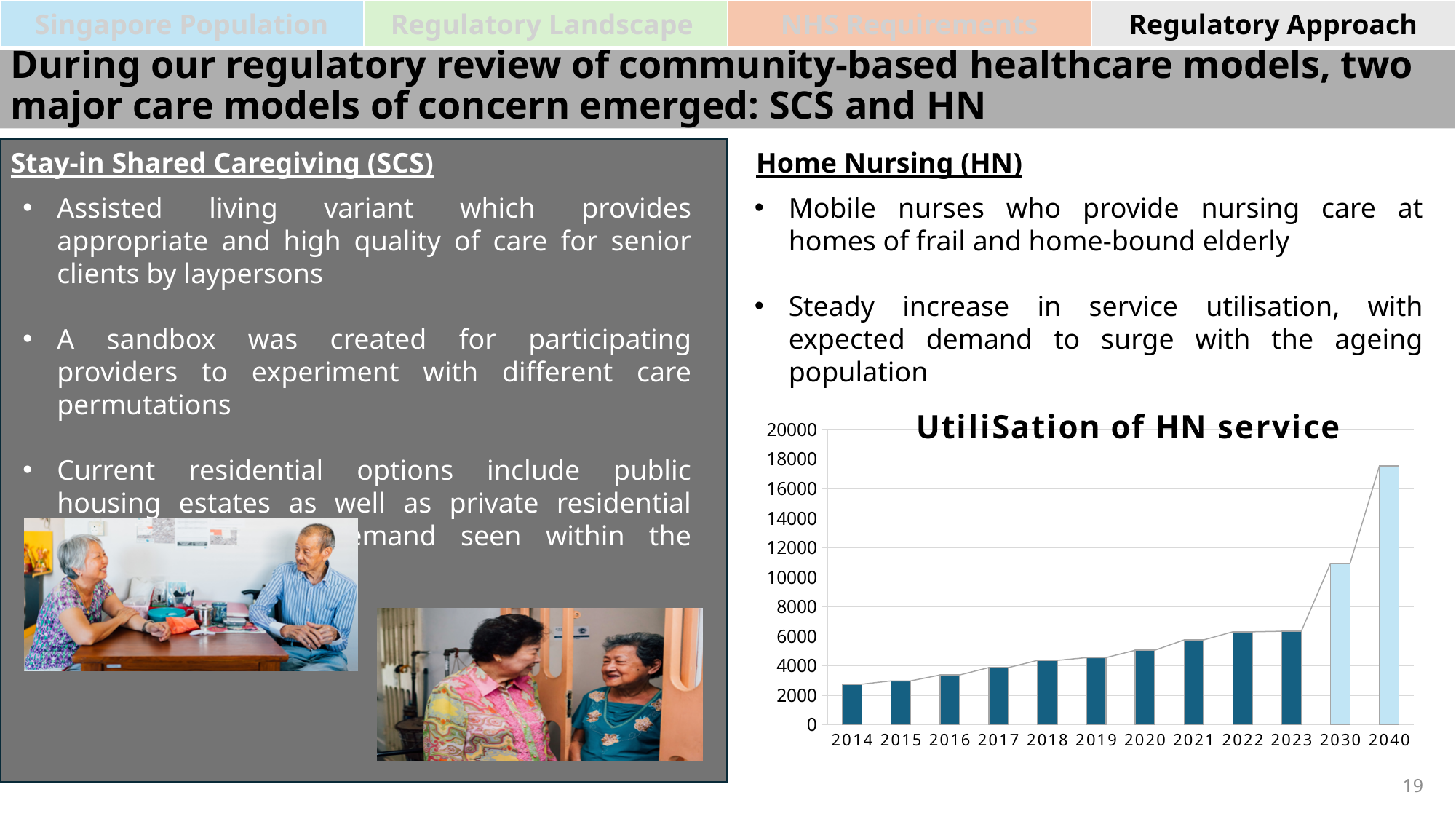
Is the value for 2030 in the 'UtiliSation of HN service' chart greater or less than 10000? greater What is the title of the chart on the slide? UtiliSation of HN service In the 'UtiliSation of HN service' chart, which year has the larger value, 2014 or 2023? 2023 In the 'UtiliSation of HN service' chart, do the values rise or fall from 2014 to 2040? rise Is the value for 2019 in the 'UtiliSation of HN service' chart greater or less than 6000? less How many years are shown on the x axis of the 'UtiliSation of HN service' chart? 12 Which year has the lowest value in the 'UtiliSation of HN service' chart? 2014 In the 'UtiliSation of HN service' chart, which year has the larger value, 2030 or 2040? 2040 What kind of chart is 'UtiliSation of HN service'? bar chart Is the value for 2040 in the 'UtiliSation of HN service' chart greater or less than 16000? greater Which year has the highest value in the 'UtiliSation of HN service' chart? 2040